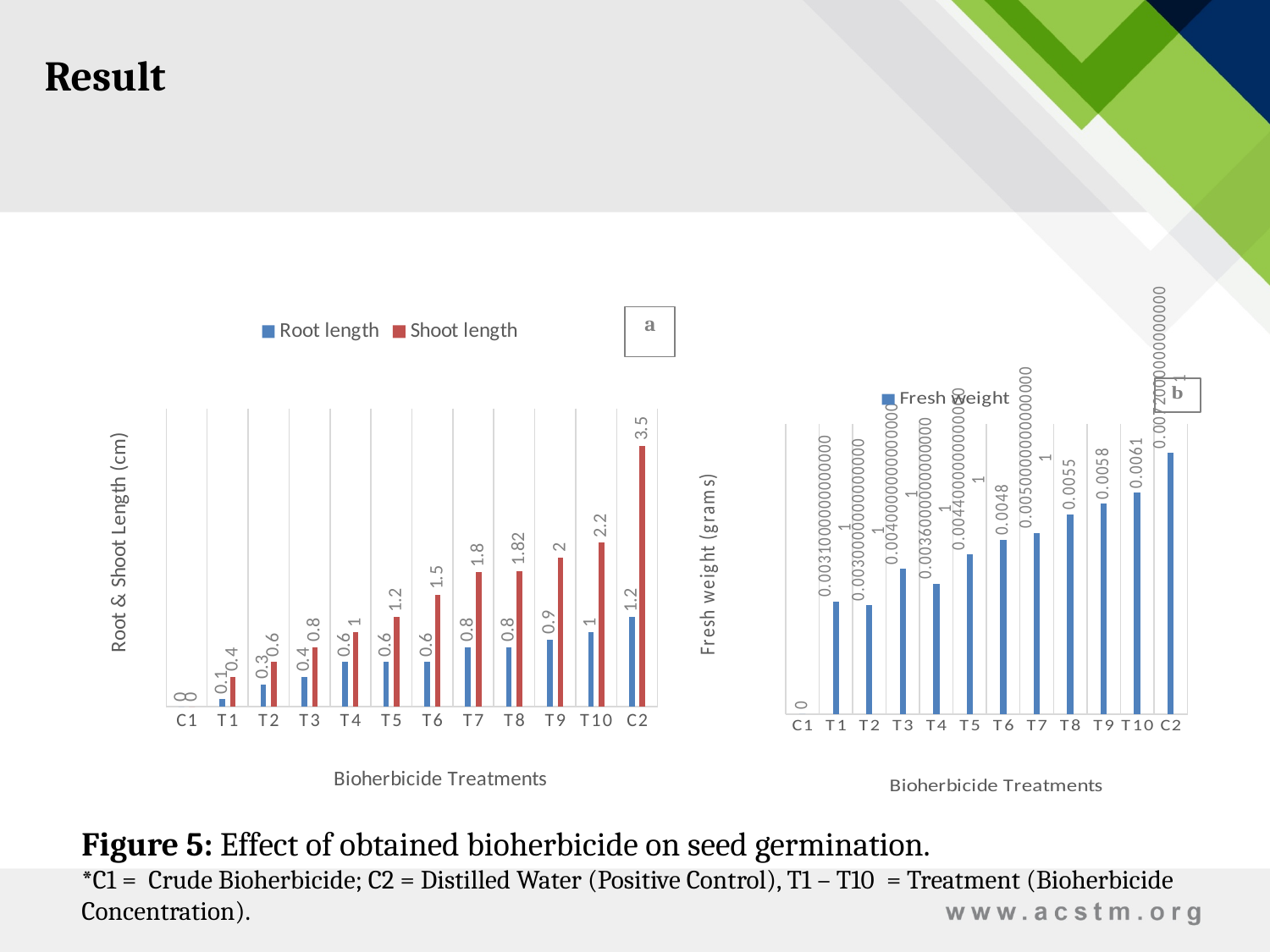
On the left chart, what is the difference between the Shoot length and Root length for T10? 1.2 On the left chart, which treatment has the highest Shoot length? C2 What type of chart is the right chart? Bar chart On the right chart, what is the Fresh weight for T8? 0.0055 On the right chart, what is the Fresh weight for T10? 0.0061 On the right chart, which treatment has the highest Fresh weight? C2 On the left chart, what is the Shoot length for T8? 1.82 On the left chart, how many treatment categories are shown on the x axis? 12 On the left chart, what is the Root length for T9? 0.9 On the left chart, which is larger: the Shoot length for T7 or the Shoot length for T5? T7 On the left chart, what is the Shoot length for C2? 3.5 On the left chart, how many series does the legend list? 2